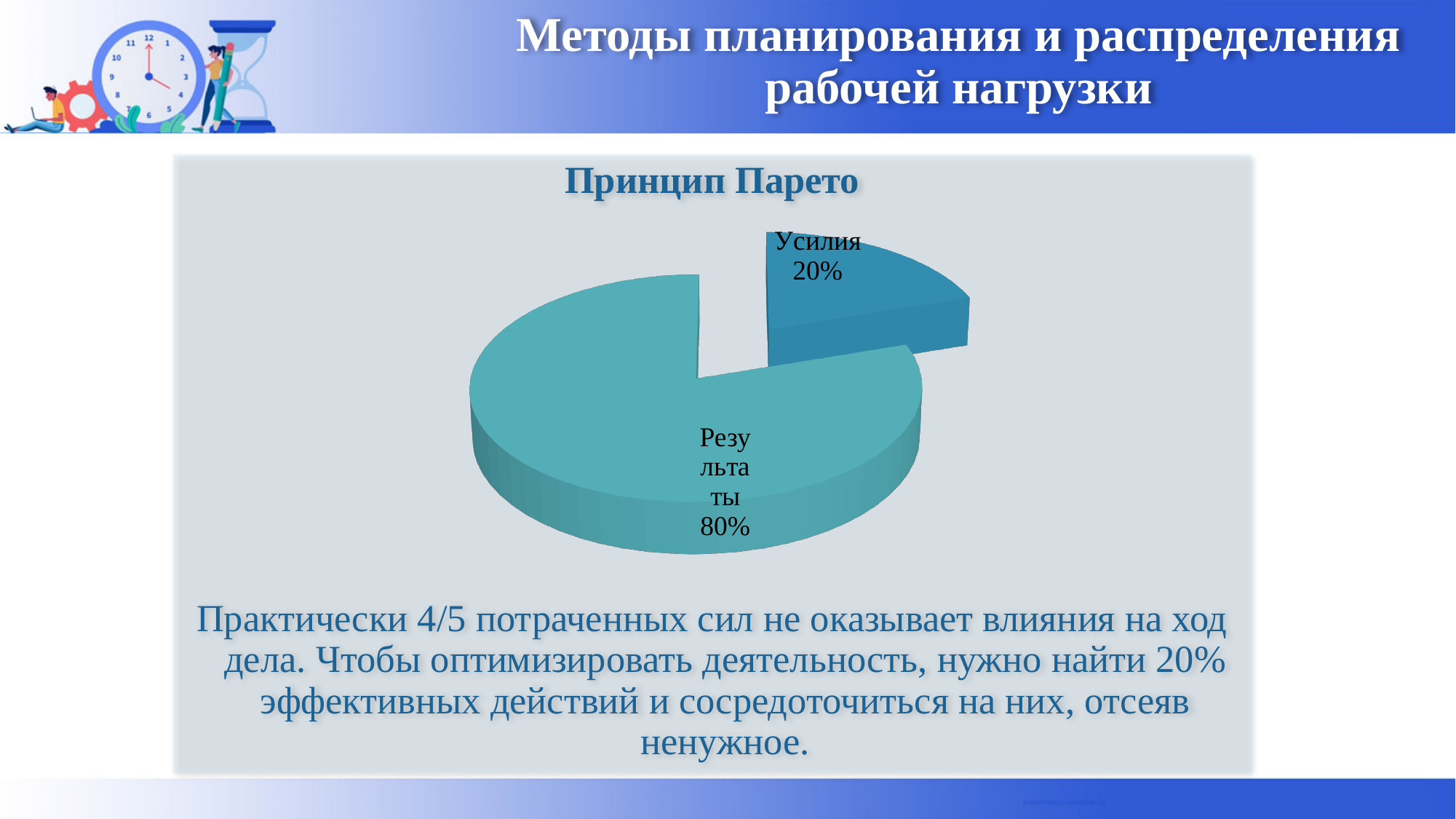
What is the value for Усилия in the pie chart? 20% Which slice of the pie chart is the largest? Результаты Which slice is pulled out (exploded) from the rest of the pie? Усилия What is the difference between the Результаты and Усилия slices? 60% What share of the pie does the Усилия slice represent? 20% How many slices does the pie chart have? 2 What type of chart is shown on the slide? pie chart Which slice of the pie chart is the smallest? Усилия What is the title of the pie chart? Принцип Парето Which is larger, the Усилия slice or the Результаты slice? Результаты What is the value for Результаты in the pie chart? 80%